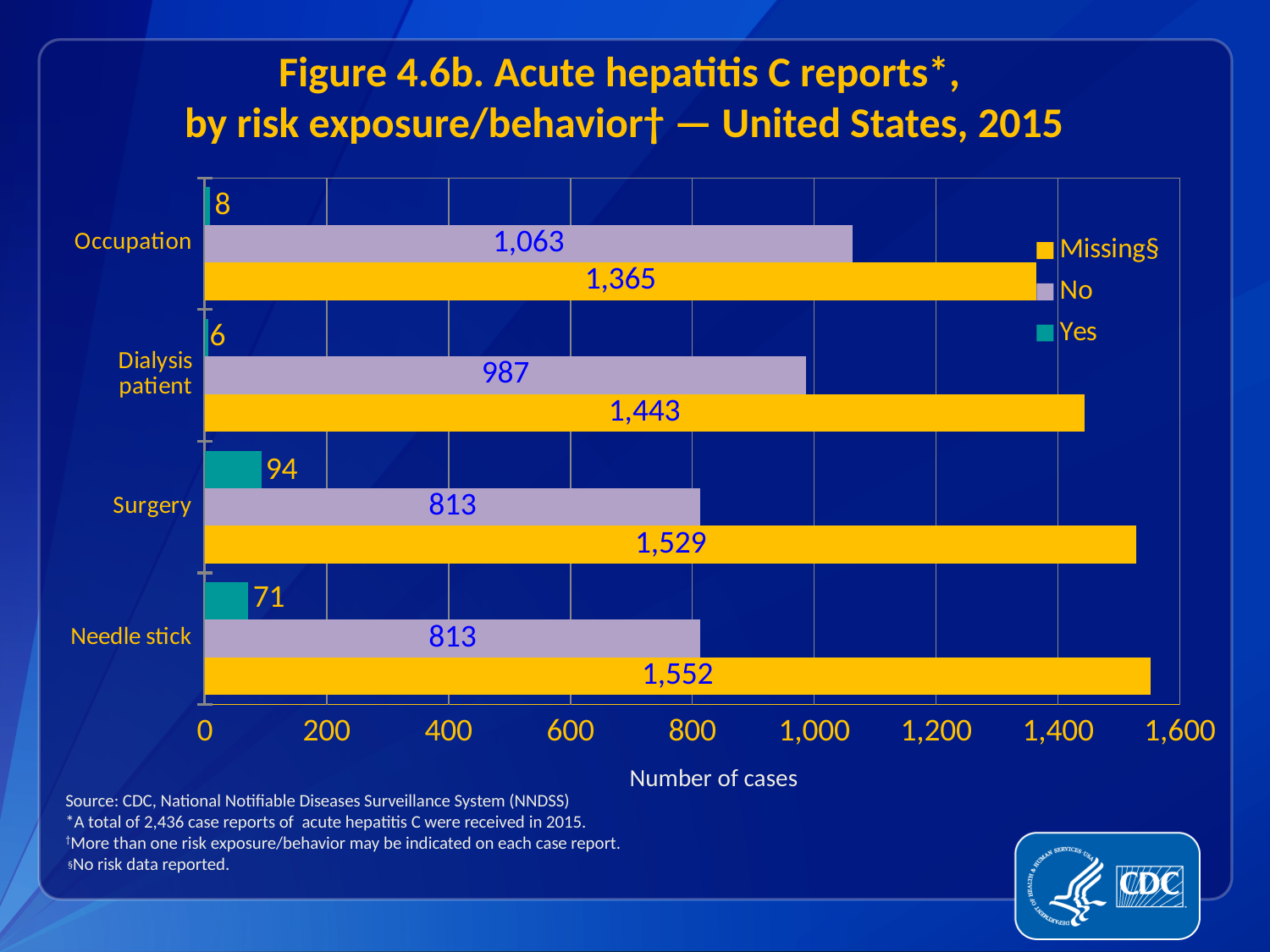
What is the number of cases with 'No' for Dialysis patient? 987 Which risk exposure/behavior has the highest 'Yes' value? Surgery What is the label of the x axis? Number of cases What kind of chart is shown on the slide? Bar chart What is the difference between the 'Missing' values for Needle stick and Occupation? 187 What is the number of cases with 'Missing' for Needle stick? 1,552 Which is larger, the 'No' value for Occupation or the 'No' value for Dialysis patient? Occupation Is the 'Missing' value for Dialysis patient greater or less than 1,400? greater How many series does the legend list? 3 What is the number of cases with 'Yes' for Surgery? 94 Which risk exposure/behavior has the lowest 'Yes' value? Dialysis patient How many risk exposure/behavior categories are shown on the chart? 4